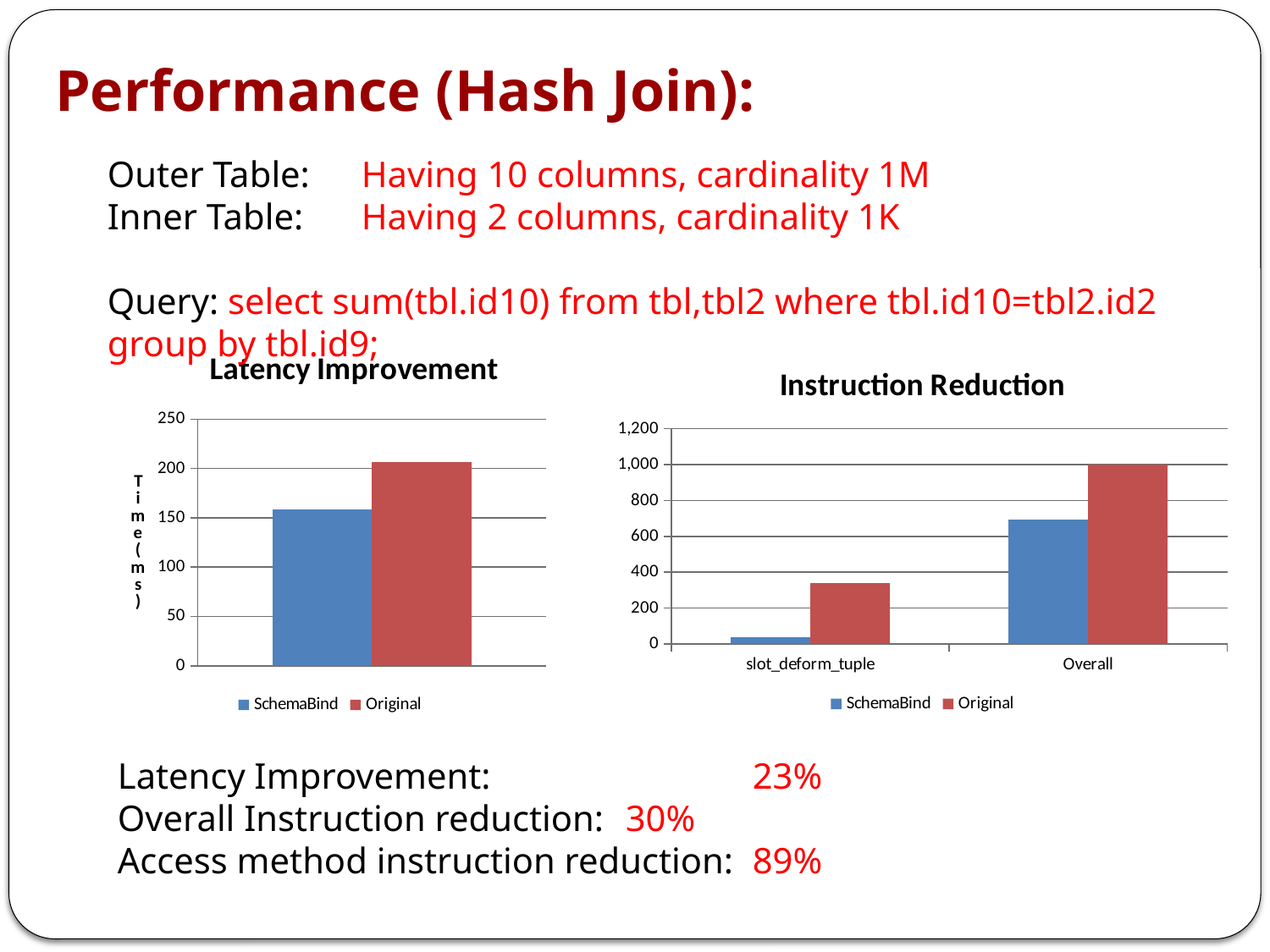
How many categories are shown on the x axis of the Instruction Reduction chart? 2 What is the y-axis label of the Latency Improvement chart? Time(ms) In the Latency Improvement chart, is the value for Original greater or less than 200? greater In the Instruction Reduction chart, which category has the highest SchemaBind value? Overall What kind of chart is the Latency Improvement chart? bar chart In the Latency Improvement chart, which series has the larger value, SchemaBind or Original? Original In the Instruction Reduction chart, is the SchemaBind value for slot_deform_tuple greater or less than 200? less In the Latency Improvement chart, is the value for SchemaBind greater or less than 200? less What kind of chart is the Instruction Reduction chart? bar chart How many series does the legend of the Instruction Reduction chart list? 2